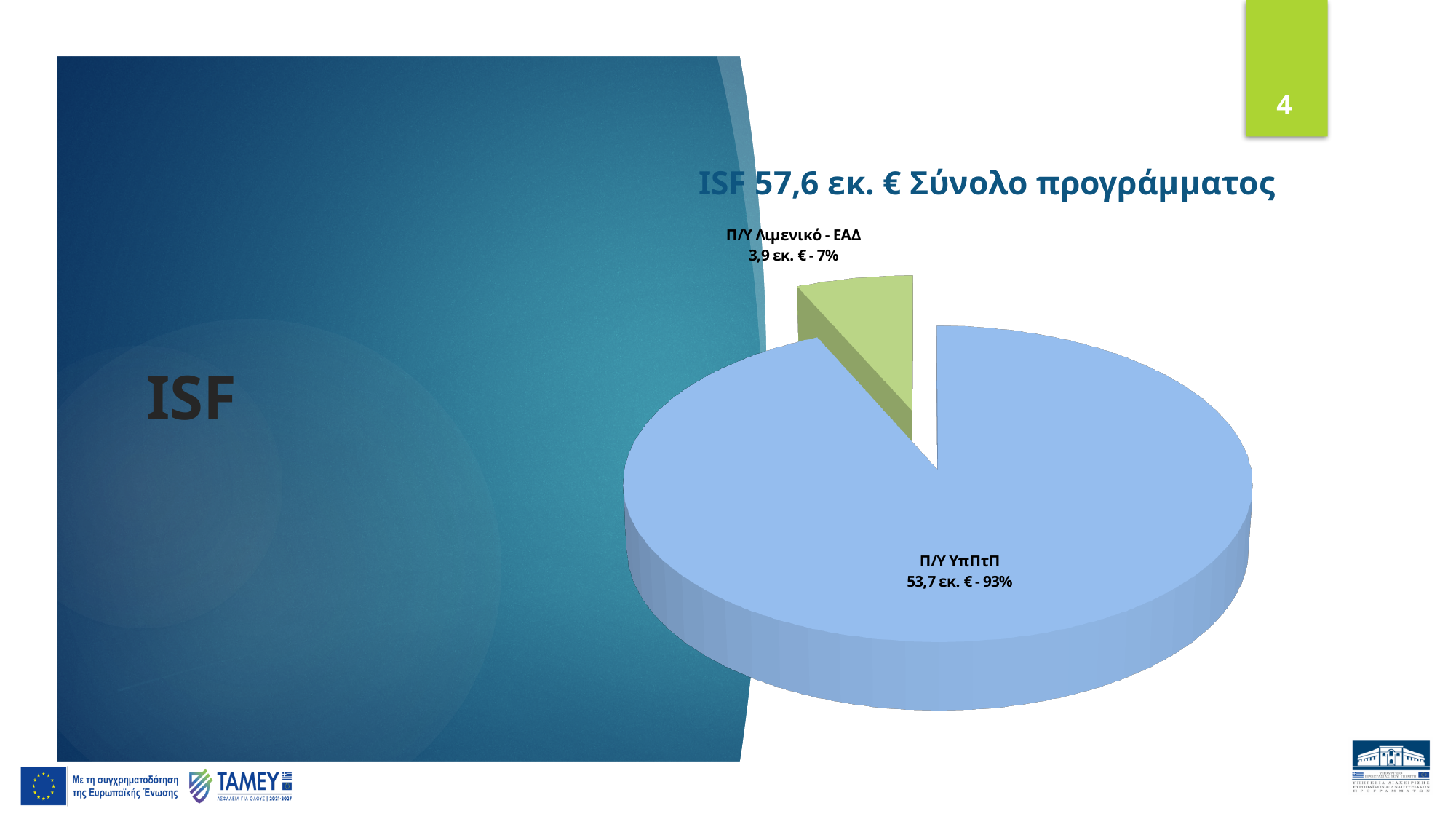
Which slice is the smallest in the pie chart? Π/Υ Λιμενικό - ΕΑΔ What share of the pie does Π/Υ ΥπΠτΠ represent? 93% What is the difference in percentage points between the Π/Υ ΥπΠτΠ share and the Π/Υ Λιμενικό - ΕΑΔ share? 86 percentage points What is the title of the pie chart? ISF 57,6 εκ. € Σύνολο προγράμματος How many slices does the pie chart have? 2 What kind of chart is shown on the slide? Pie chart Which slice is the largest in the pie chart? Π/Υ ΥπΠτΠ What share of the pie does Π/Υ Λιμενικό - ΕΑΔ represent? 7% What colour is the Π/Υ Λιμενικό - ΕΑΔ slice? Green What is the value shown for Π/Υ ΥπΠτΠ? 53,7 εκ. € What is the value shown for Π/Υ Λιμενικό - ΕΑΔ? 3,9 εκ. € Which is larger, the value for Π/Υ ΥπΠτΠ or the value for Π/Υ Λιμενικό - ΕΑΔ? Π/Υ ΥπΠτΠ